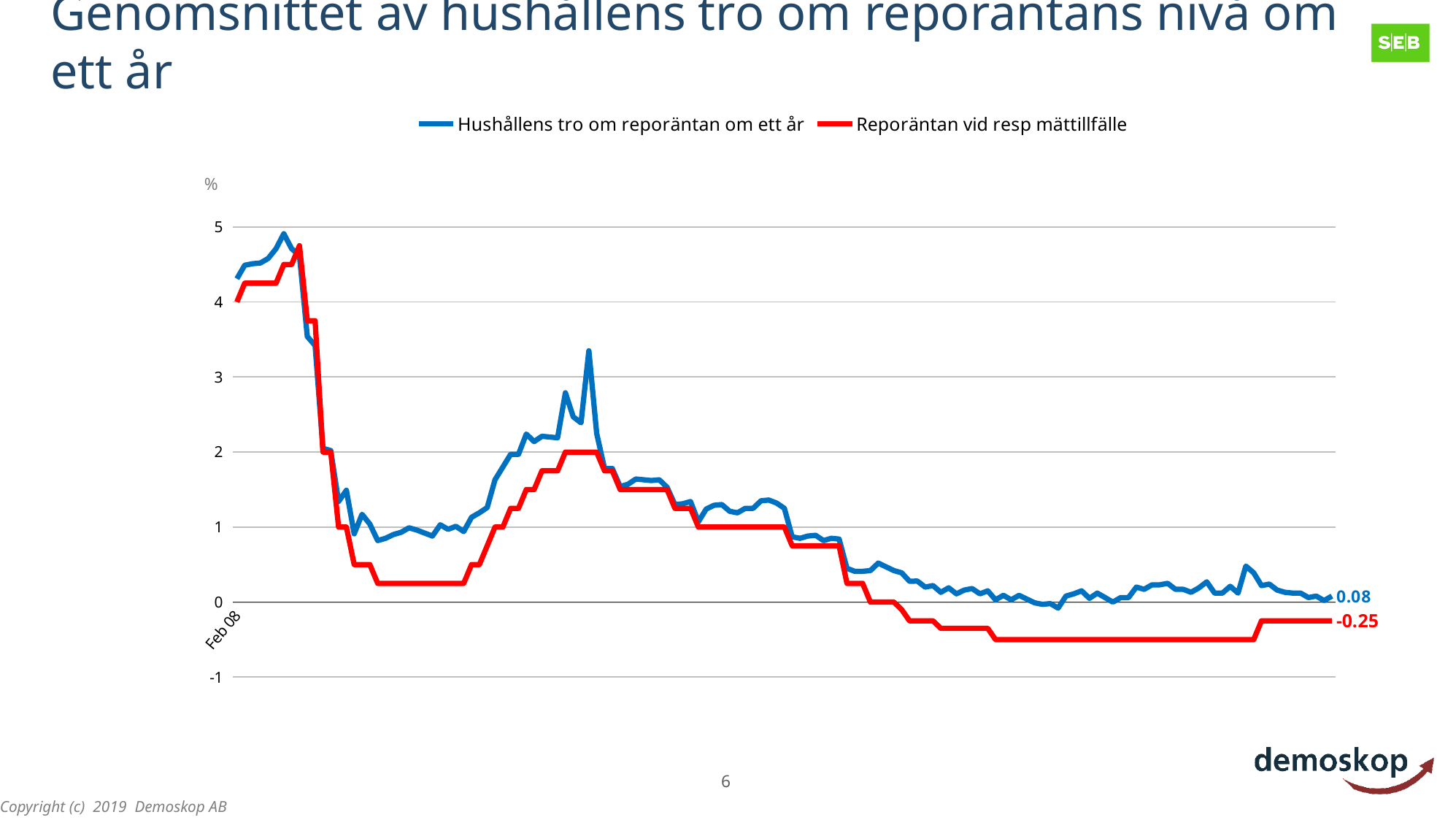
Is the lowest value reached by the red series 'Reporäntan vid resp mättillfälle' greater or less than 0? less What kind of chart is shown on the slide? line chart What unit is shown on the y axis of the chart? % What is the final labelled value of the series 'Hushållens tro om reporäntan om ett år'? 0.08 Overall, do the values of the series 'Reporäntan vid resp mättillfälle' rise or fall from the left of the chart to the right? fall What is the difference between the final labelled values of the two series (0.08 and -0.25)? 0.33 How many series does the legend list? 2 What is the first x-axis label shown on the chart? Feb 08 Is the highest value reached by the blue series 'Hushållens tro om reporäntan om ett år' greater or less than 4? greater At the end of the chart, which series has the higher value: 'Hushållens tro om reporäntan om ett år' or 'Reporäntan vid resp mättillfälle'? Hushållens tro om reporäntan om ett år What is the final labelled value of the series 'Reporäntan vid resp mättillfälle'? -0.25